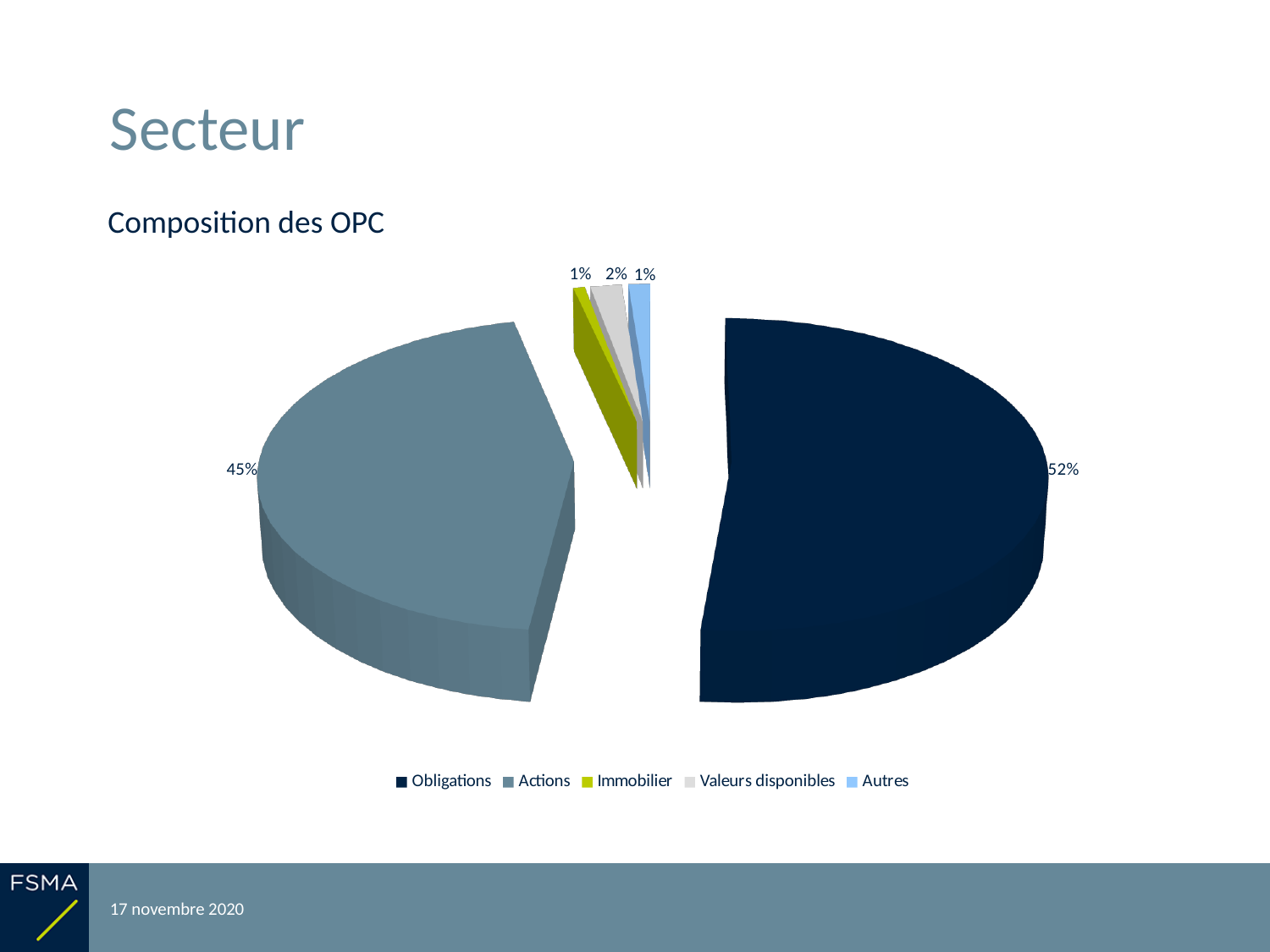
What percentage of the pie is Autres? 1% What percentage of the pie is Actions? 45% Which is larger, the share for Obligations or the share for Actions? Obligations What is the title of the chart? Composition des OPC What percentage of the pie is Valeurs disponibles? 2% What type of chart is shown on the slide? pie chart How many categories does the legend list? 5 What percentage of the pie is Obligations? 52% What percentage of the pie is Immobilier? 1% Which category has the largest share of the pie? Obligations What is the difference in percentage points between the Obligations share and the Actions share? 7 Which category is shown in green in the legend? Immobilier